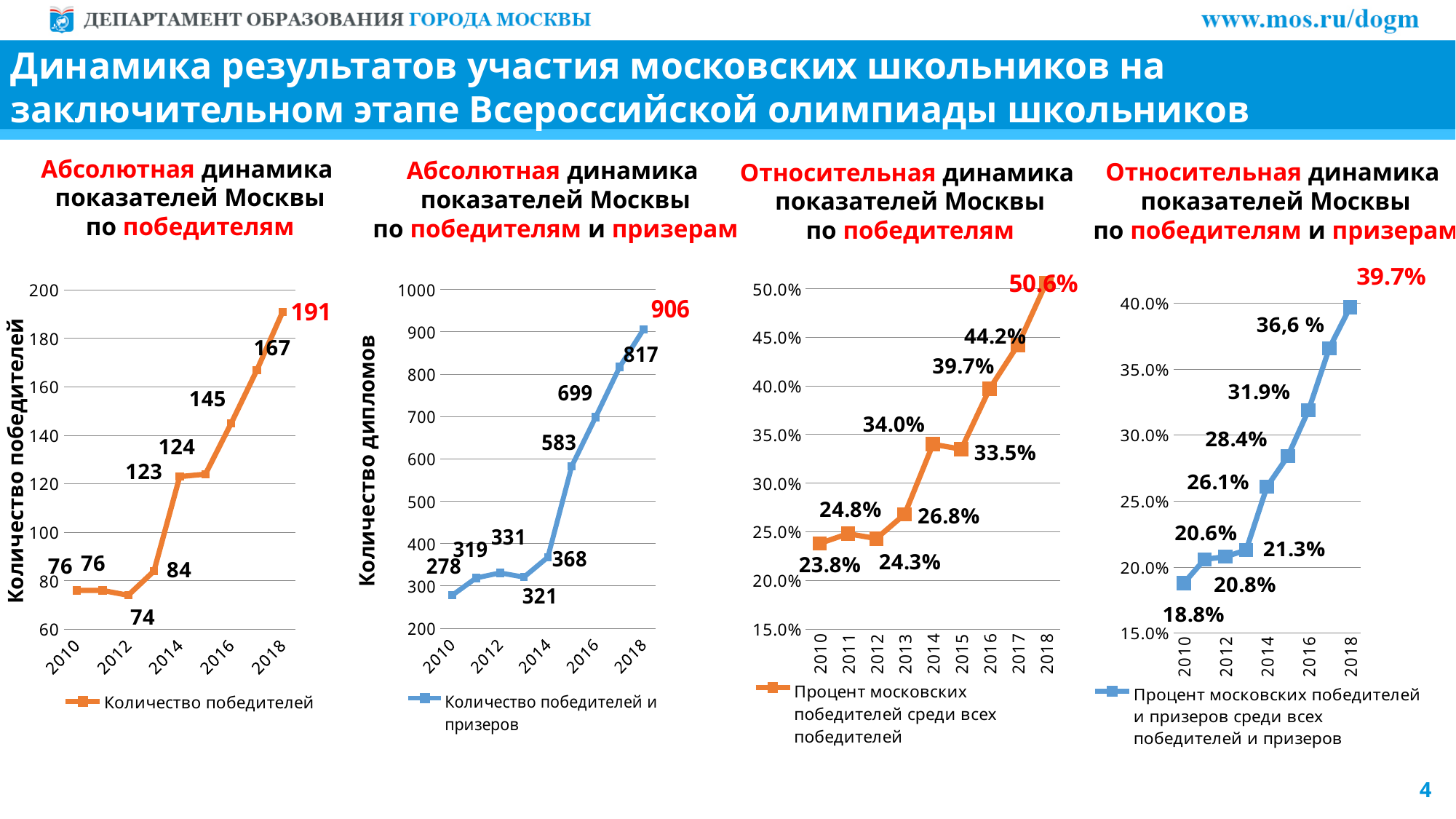
In the second chart from the left (Абсолютная динамика показателей Москвы по победителям и призерам), what is the value for 2015? 583 In the rightmost chart (Относительная динамика показателей Москвы по победителям и призерам), what is the value for 2010? 18.8% In the third chart from the left (Относительная динамика показателей Москвы по победителям), which is larger, the value for 2014 or the value for 2015? 2014 In the leftmost chart (Абсолютная динамика показателей Москвы по победителям), what is the value for 2018? 191 In the rightmost chart (Относительная динамика показателей Москвы по победителям и призерам), what is the difference between the 2018 value and the 2017 value? 3.1% In the third chart from the left (Относительная динамика показателей Москвы по победителям), what is the value for 2014? 34.0% In the leftmost chart (Абсолютная динамика показателей Москвы по победителям), what is the difference between the 2018 value and the 2010 value? 115 In the rightmost chart (Относительная динамика показателей Москвы по победителям и призерам), do the values rise or fall from 2010 to 2018? Rise In the second chart from the left (Абсолютная динамика показателей Москвы по победителям и призерам), how many data points are plotted? 9 In the leftmost chart (Абсолютная динамика показателей Москвы по победителям), which year has the lowest value? 2012 What type of chart is the leftmost chart (Абсолютная динамика показателей Москвы по победителям)? Line chart In the second chart from the left (Абсолютная динамика показателей Москвы по победителям и призерам), which year has the highest value? 2018